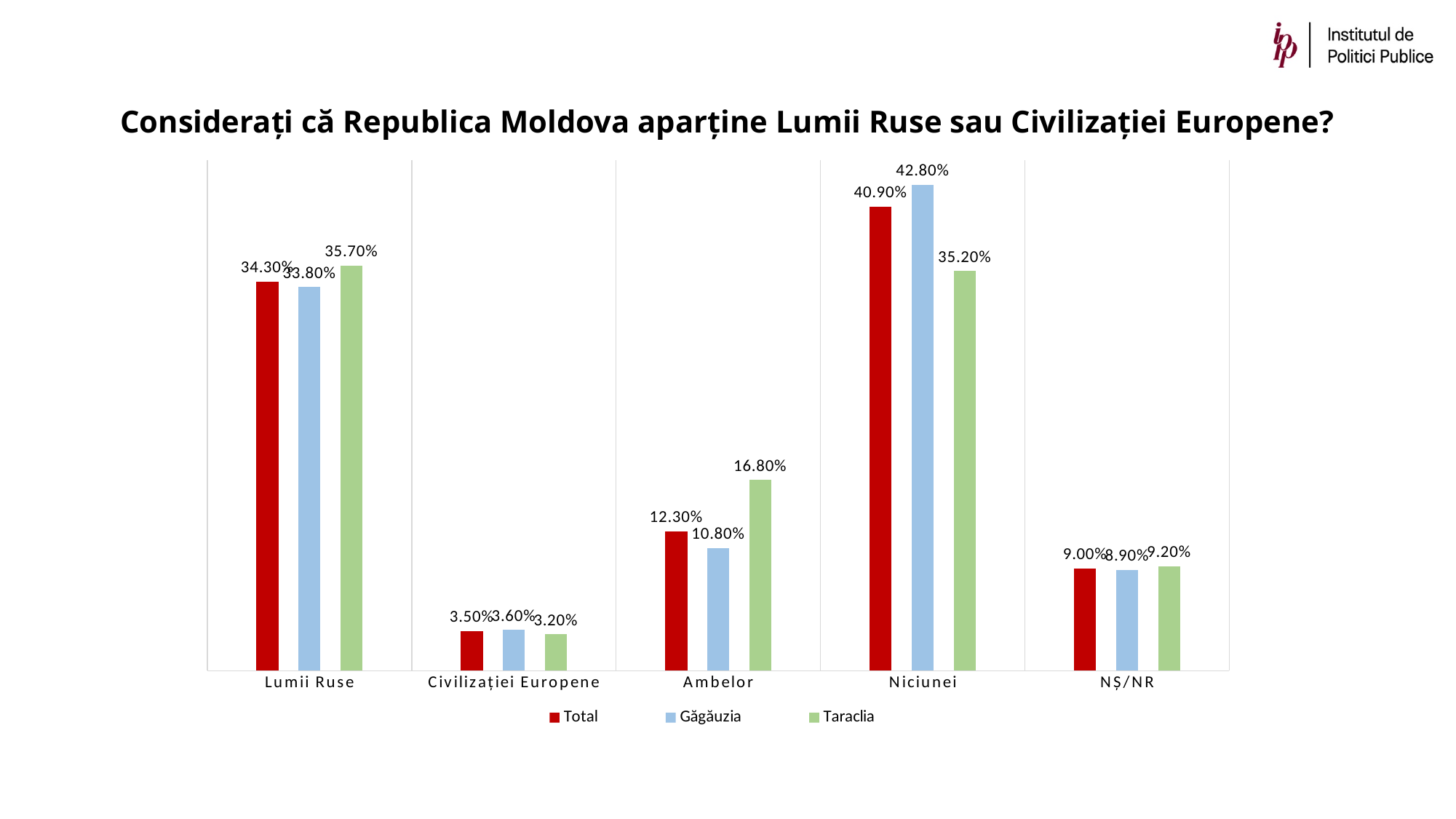
What is the difference between the Găgăuzia and Taraclia values for Niciunei? 7.60% Which colour represents the Total series? Red What is the Găgăuzia value for Lumii Ruse? 33.80% Which category has the highest Găgăuzia value? Niciunei What is the Taraclia value for Ambelor? 16.80% Which is larger for Ambelor: the Total value or the Taraclia value? Taraclia What kind of chart is shown on the slide? Bar chart What is the Total value for Civilizației Europene? 3.50% Which category has the lowest Taraclia value? Civilizației Europene How many categories are shown on the x axis? 5 How many series does the legend list? 3 What is the Total value for Niciunei? 40.90%